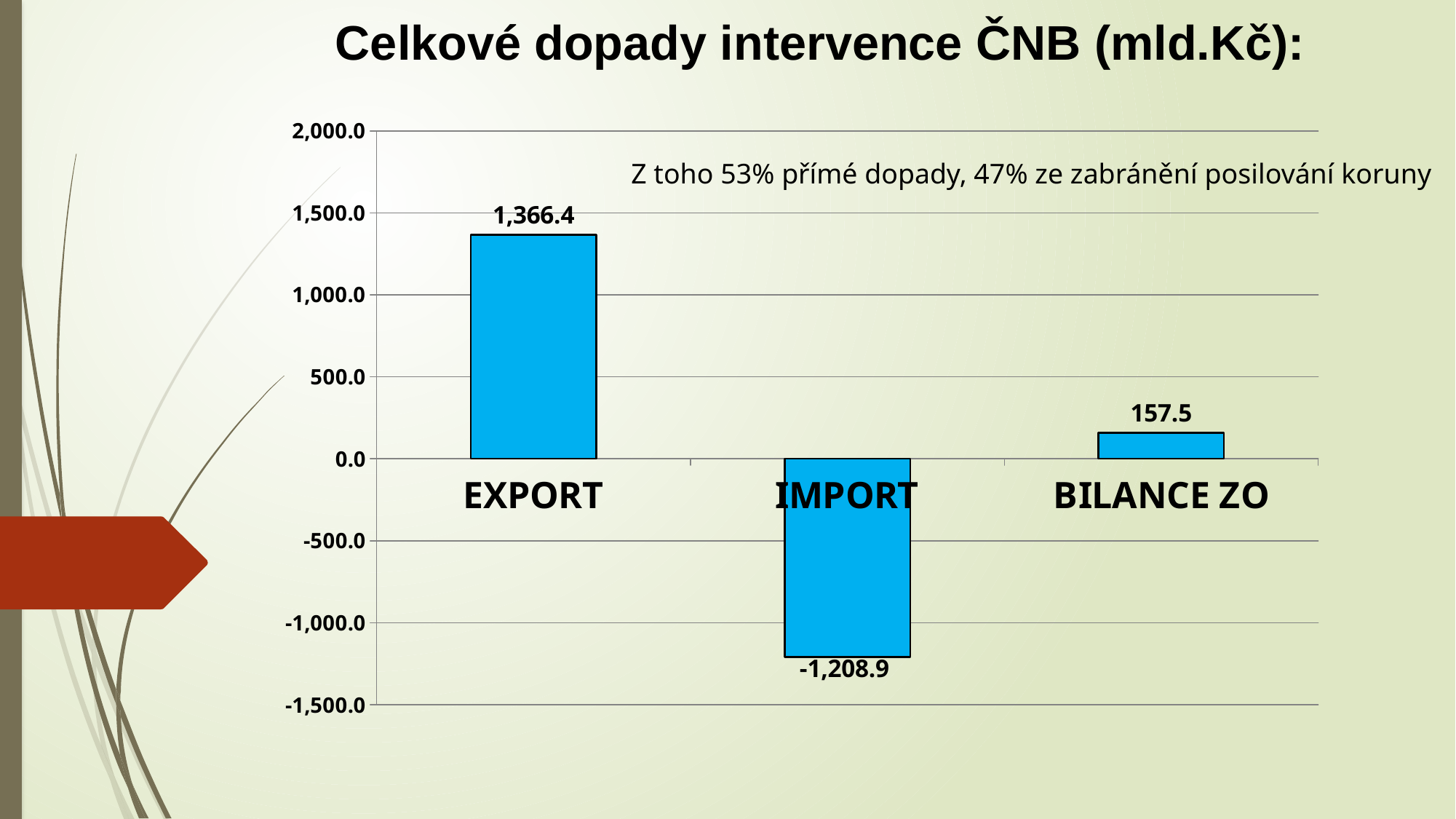
What is the difference between the EXPORT value and the BILANCE ZO value? 1,208.9 Which is larger, the value for EXPORT or the value for BILANCE ZO? EXPORT What is the title of the slide's chart? Celkové dopady intervence ČNB (mld.Kč): What is the value for EXPORT? 1,366.4 What kind of chart is shown on the slide? bar chart What is the value for IMPORT? -1,208.9 Which category has the highest value? EXPORT Is the value for IMPORT greater or less than -1,000.0? less Is the value for EXPORT greater or less than 1,000.0? greater Which category has the lowest value? IMPORT How many categories are shown on the x axis? 3 What is the value for BILANCE ZO? 157.5